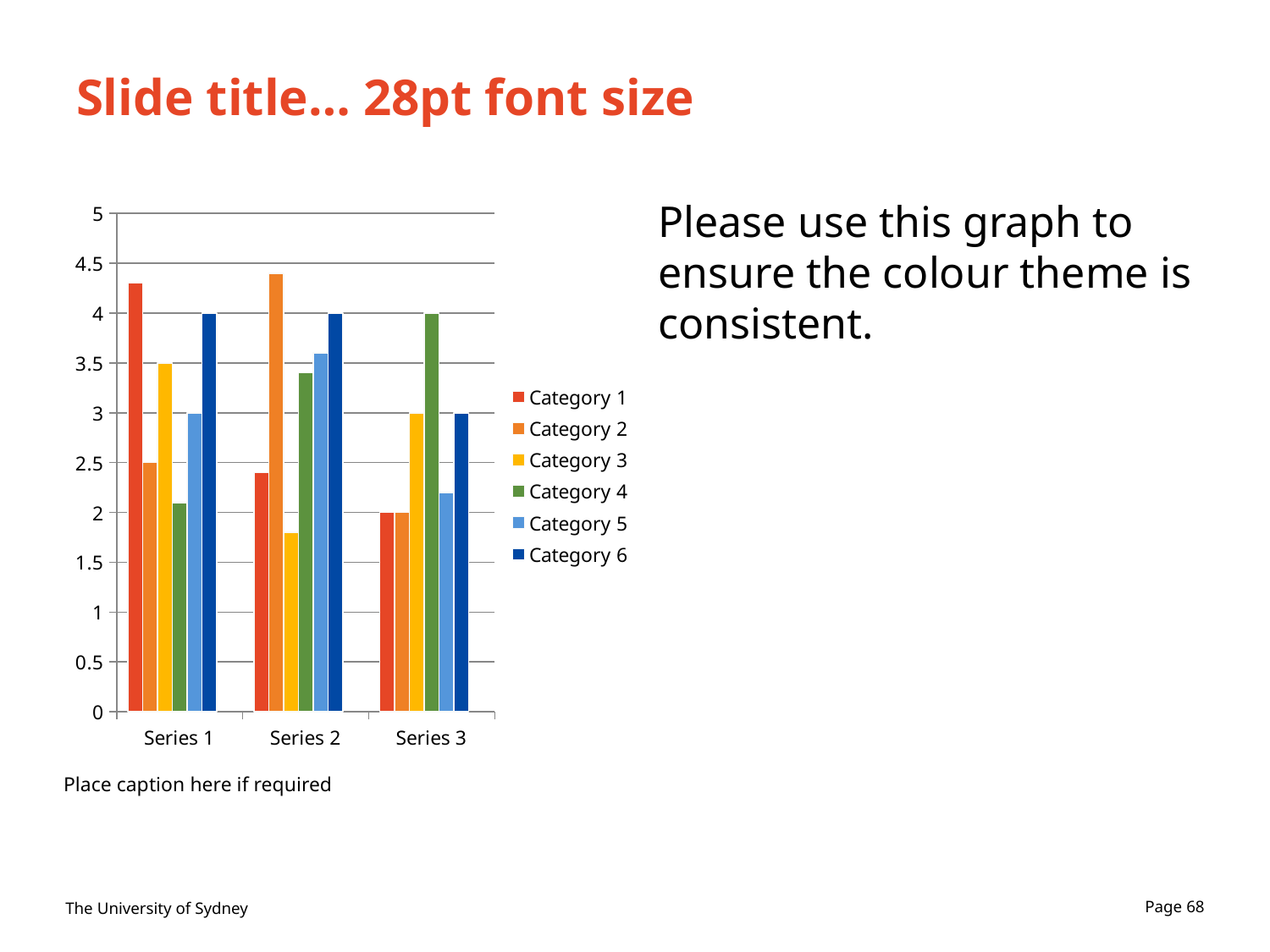
How many series does the legend list? 6 Do the values for Category 1 rise or fall from Series 1 to Series 3? fall In the Series 3 group, which is larger: Category 4 or Category 5? Category 4 What is the caption text shown below the chart? Place caption here if required Is the value for Category 1 in Series 1 greater or less than 4? greater Is the value for Category 4 in Series 1 greater or less than 2.5? less What kind of chart is shown on the slide? bar chart How many groups are shown along the x axis? 3 Is the value for Category 3 in Series 2 greater or less than 2? less Which category has the highest bar in the Series 1 group? Category 1 Which category has the lowest bar in the Series 2 group? Category 3 Which category has the highest bar in the Series 2 group? Category 2